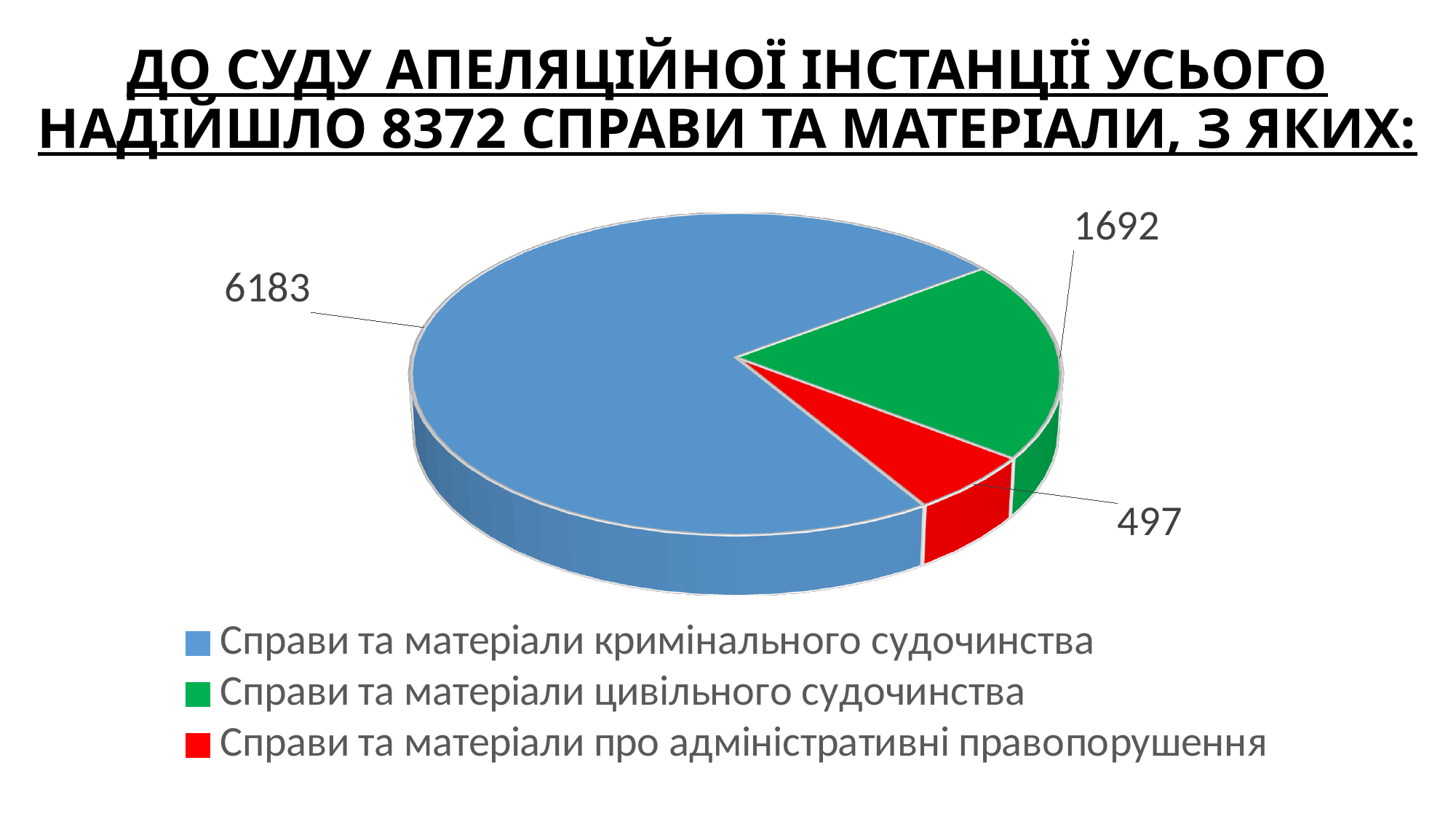
What is the value for 'Справи та матеріали цивільного судочинства'? 1692 How many slices does the pie chart have? 3 How many entries does the legend list? 3 What is the value for 'Справи та матеріали про адміністративні правопорушення'? 497 Which is larger: the value for civil proceedings (цивільного судочинства) or for administrative offences (адміністративні правопорушення)? Справи та матеріали цивільного судочинства What is the value for 'Справи та матеріали кримінального судочинства'? 6183 Which category has the smallest slice of the pie? Справи та матеріали про адміністративні правопорушення Which category has the largest slice of the pie? Справи та матеріали кримінального судочинства What kind of chart is shown on the slide? pie chart What is the total of all three slices of the pie? 8372 What is the difference between the values for criminal proceedings (кримінального судочинства) and civil proceedings (цивільного судочинства)? 4491 What colour is the slice for 'Справи та матеріали про адміністративні правопорушення'? red